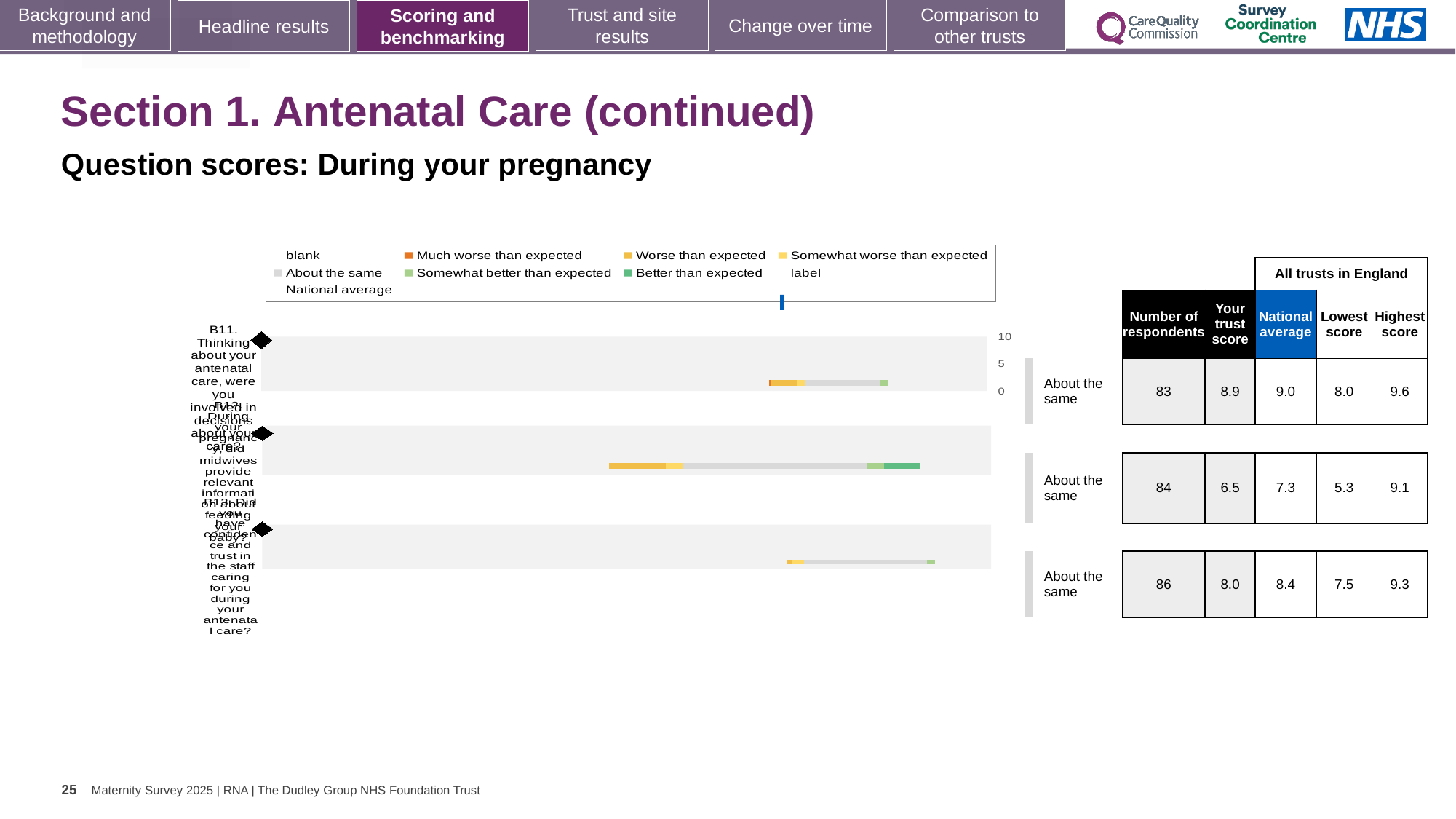
How many questions (bars) are plotted in the chart? 3 For question B11, which is larger: the trust score or the national average? National average Which question has the lowest trust score? B12 What is the national average for question B11 (were you involved in decisions about your care)? 9.0 What is the lowest score across all trusts in England for question B13? 7.5 How many respondents answered question B13? 86 What is the trust score for question B12 (did midwives provide relevant information about feeding your baby)? 6.5 What kind of chart is shown on the slide? bar chart What is the highest score across all trusts in England for question B12? 9.1 What benchmark category is shown next to each of the three questions? About the same What is the difference between the national average and the trust score for question B12? 0.8 Which question has the highest number of respondents? B13